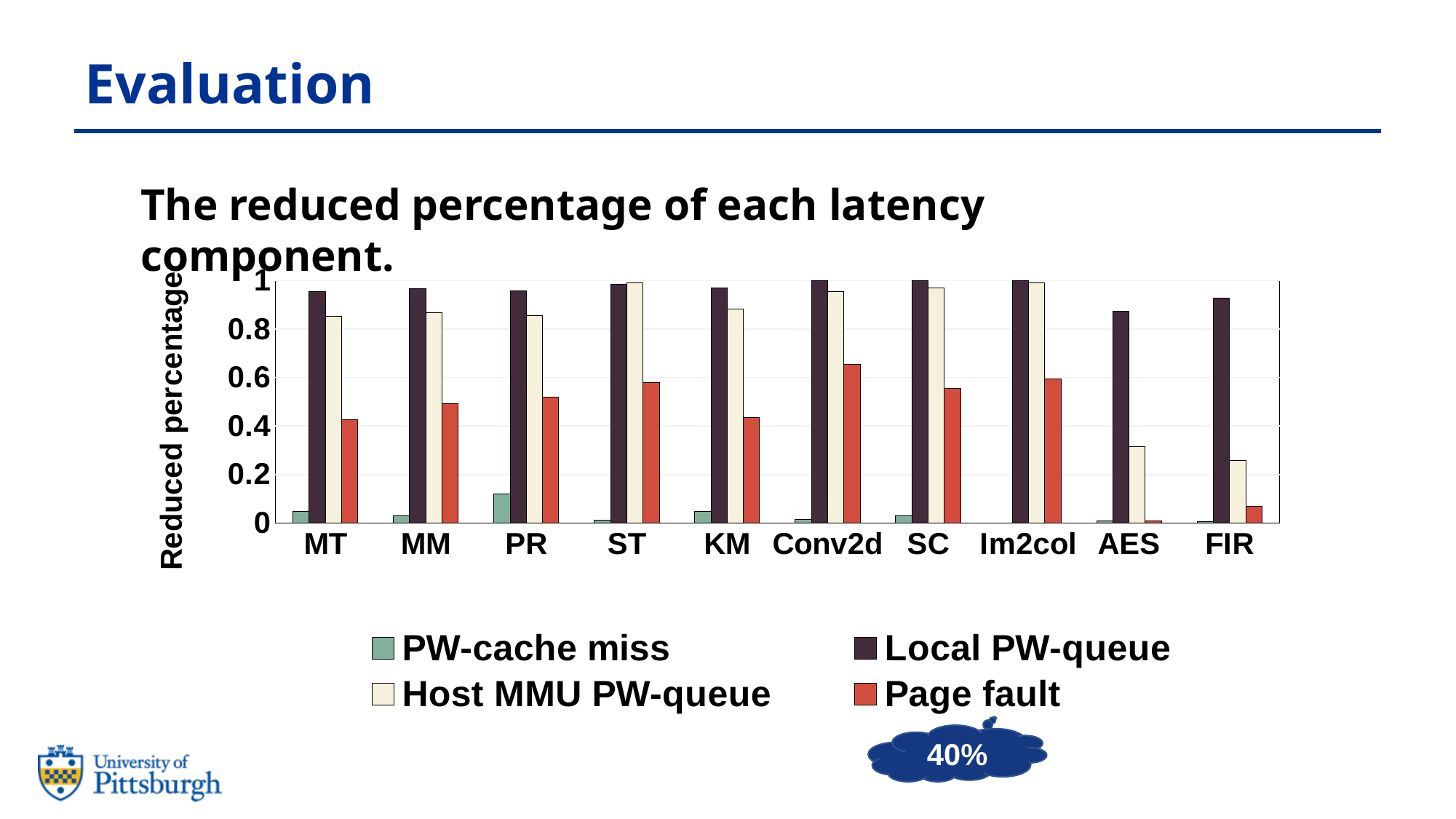
What is the label of the y axis? Reduced percentage Which category has the highest Page fault value? Conv2d How many categories (benchmarks) are shown on the x axis? 10 Which series is drawn in red? Page fault Which category has the lowest Local PW-queue value? AES Which category has the lowest Host MMU PW-queue value? FIR What kind of chart is shown on the slide? bar chart Is the Page fault value for Conv2d greater or less than 0.6? greater How many series does the legend list? 4 Is the Host MMU PW-queue value for AES greater or less than 0.4? less Which is larger, the Page fault value for ST or for MT? ST Which category has the highest PW-cache miss value? PR